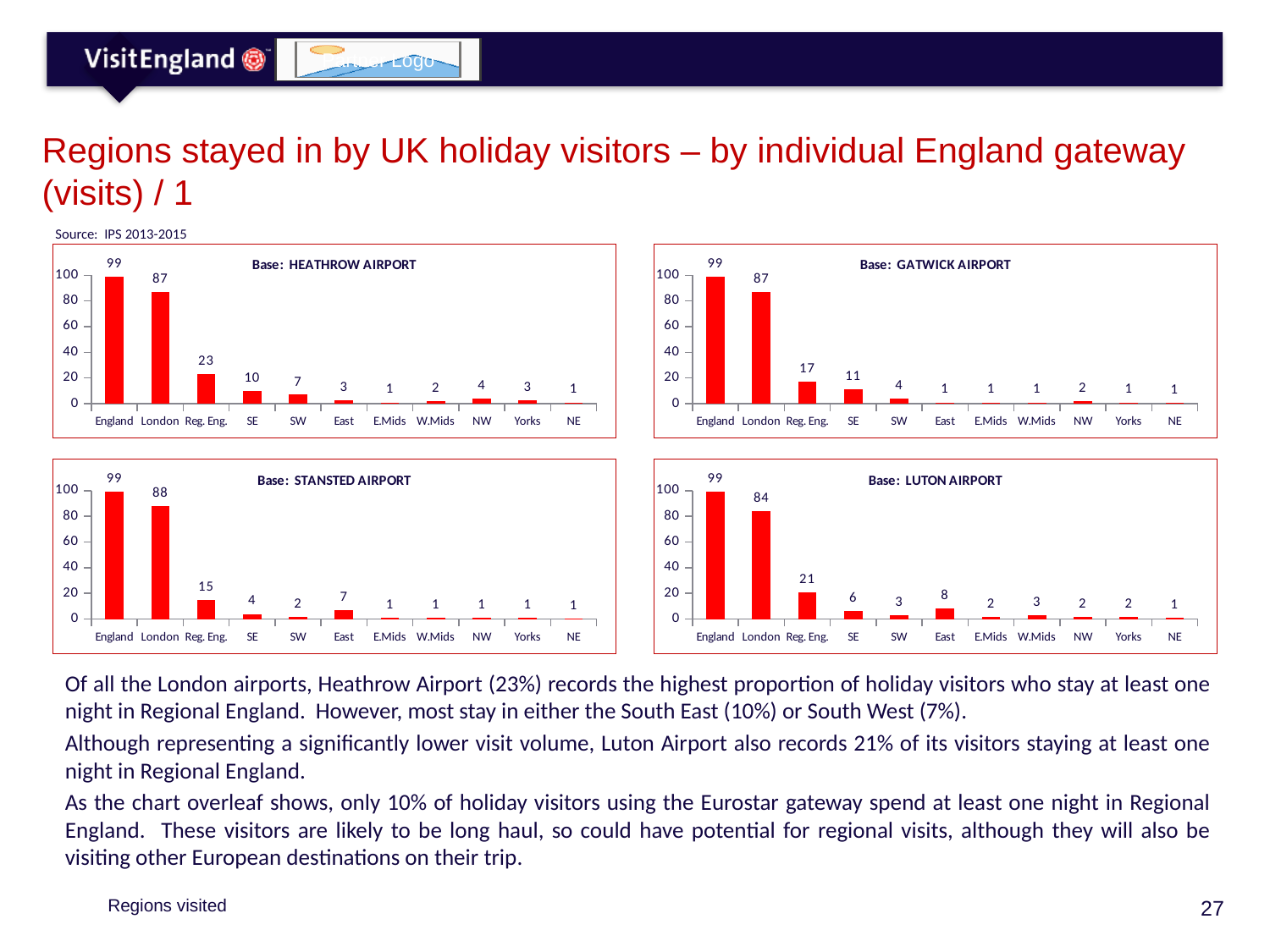
In the Gatwick Airport chart, is the value for Reg. Eng. greater or less than 20? less What is the source cited for the charts on the slide? IPS 2013-2015 In the Stansted Airport chart, what is the value for London? 88 In the Heathrow Airport chart, what is the value for Reg. Eng.? 23 In the Stansted Airport chart, which is larger, the value for East or the value for SE? East In the Gatwick Airport chart, what is the value for SE? 11 How many categories are shown on the x axis of the Heathrow Airport chart? 11 In the Luton Airport chart, which category has the highest value? England In the Luton Airport chart, what is the difference between the values for Reg. Eng. and SE? 15 In the Luton Airport chart, what is the value for East? 8 In the Heathrow Airport chart, what is the difference between the values for England and London? 12 What kind of chart is the Luton Airport chart? Bar chart